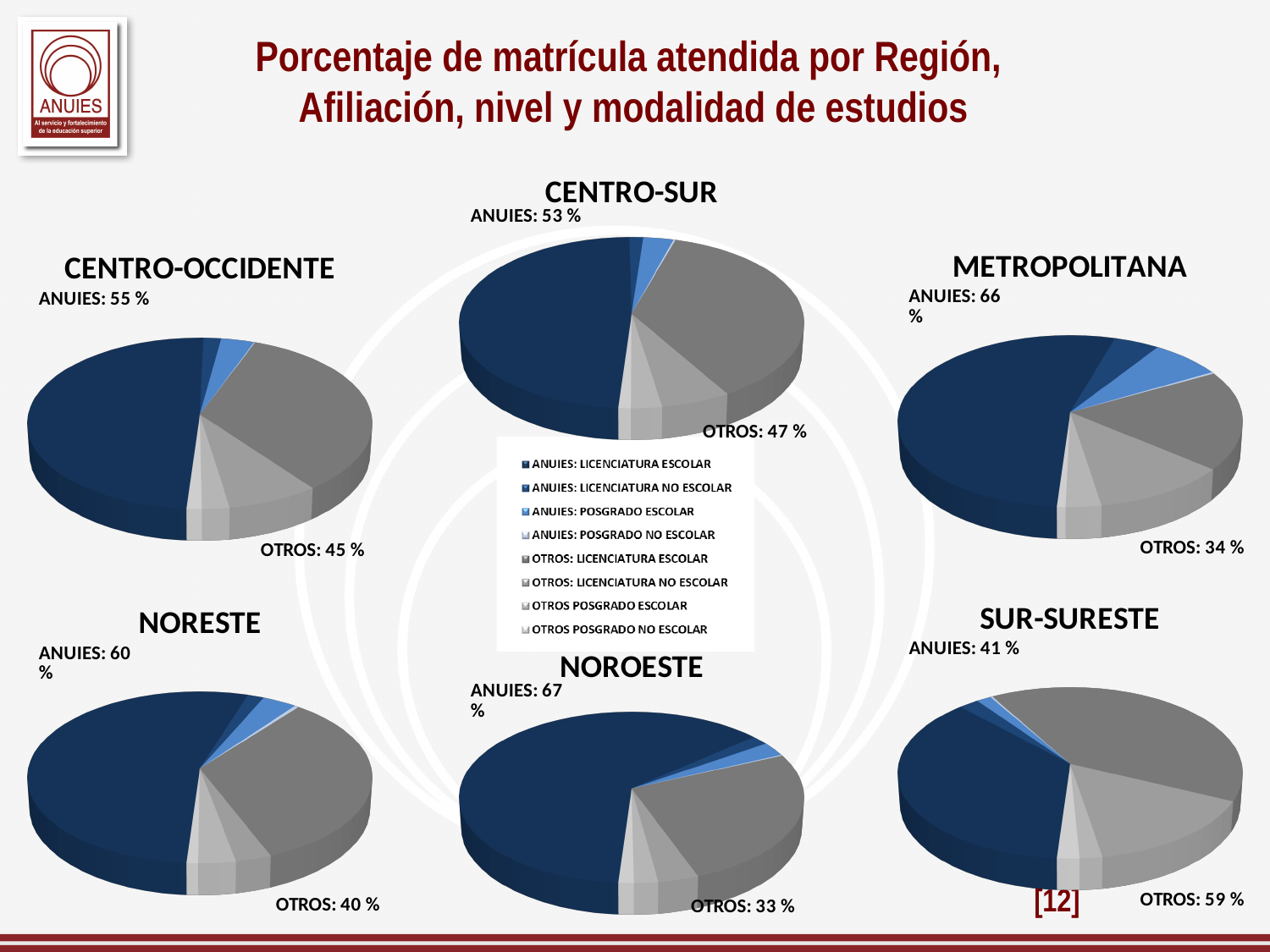
In the CENTRO-OCCIDENTE pie chart, what percentage is labelled for ANUIES? 55 % In the NORESTE pie chart, what percentage is labelled for OTROS? 40 % In the SUR-SURESTE pie chart, which is larger, the ANUIES share or the OTROS share? OTROS What type of chart is used for each region on the slide? Pie chart Across the six regional pie charts, which region has the lowest ANUIES percentage? SUR-SURESTE In the NOROESTE pie chart, what is the difference between the ANUIES percentage and the OTROS percentage? 34 % How many entries does the shared legend in the centre of the slide list? 8 In the SUR-SURESTE pie chart, what percentage is labelled for ANUIES? 41 % How many regional pie charts are shown on the slide? 6 In the CENTRO-SUR pie chart, which is larger, the ANUIES share or the OTROS share? ANUIES Across the six regional pie charts, which region has the highest ANUIES percentage? NOROESTE In the METROPOLITANA pie chart, what percentage is labelled for OTROS? 34 %